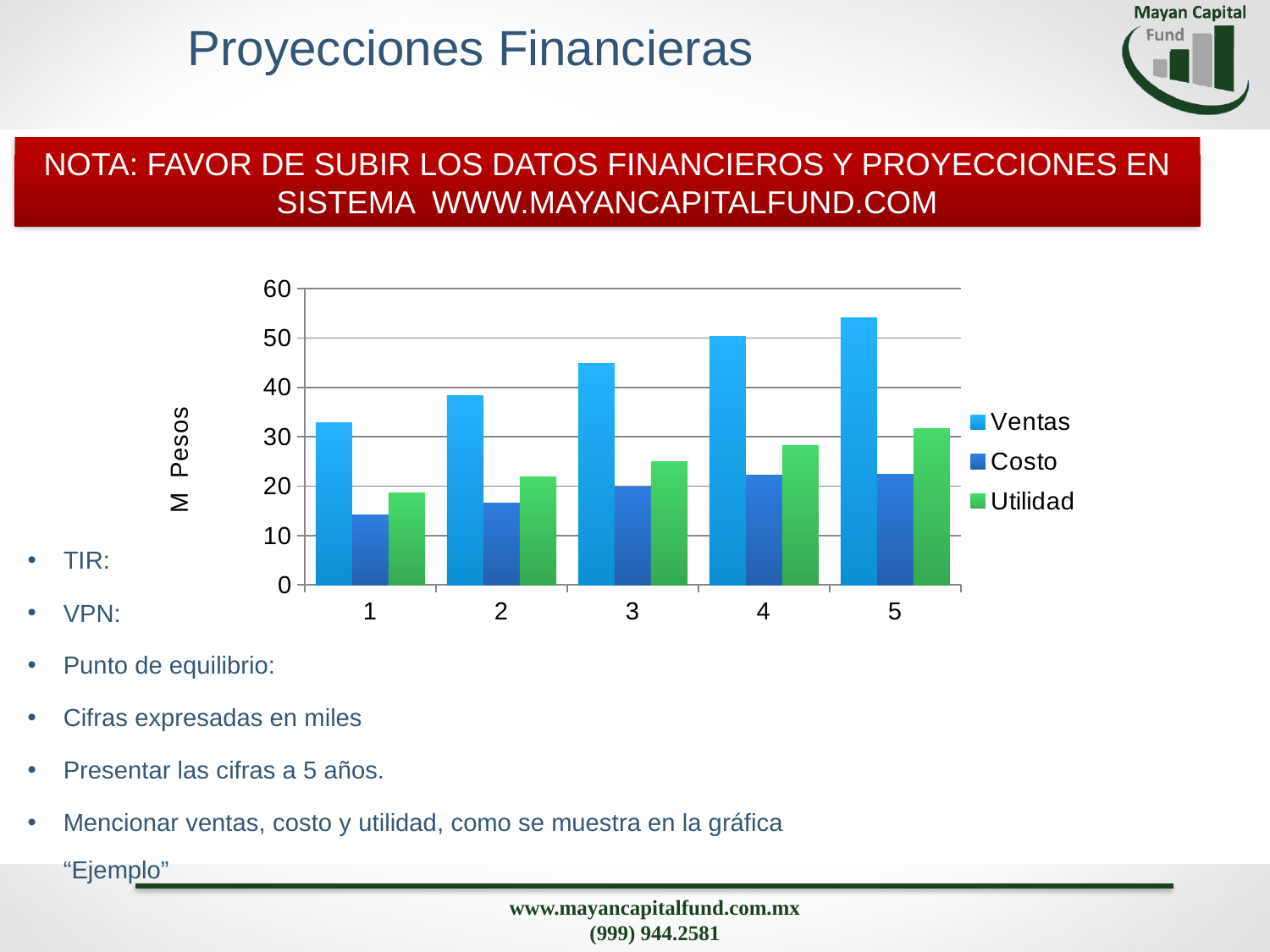
What is the label on the vertical axis of the chart? M Pesos How many series does the chart legend list? 3 In category 2, which is larger, Ventas or Utilidad? Ventas Do the Ventas values rise or fall from category 1 to category 5? rise How many categories are shown on the x axis of the chart? 5 Is the Costo value for category 1 greater or less than 20? less Which category has the highest Ventas value? 5 What kind of chart is shown on the slide? bar chart Is the Ventas value for category 5 greater or less than 50? greater Is the Ventas value for category 3 greater or less than 50? less Which category has the lowest Costo value? 1